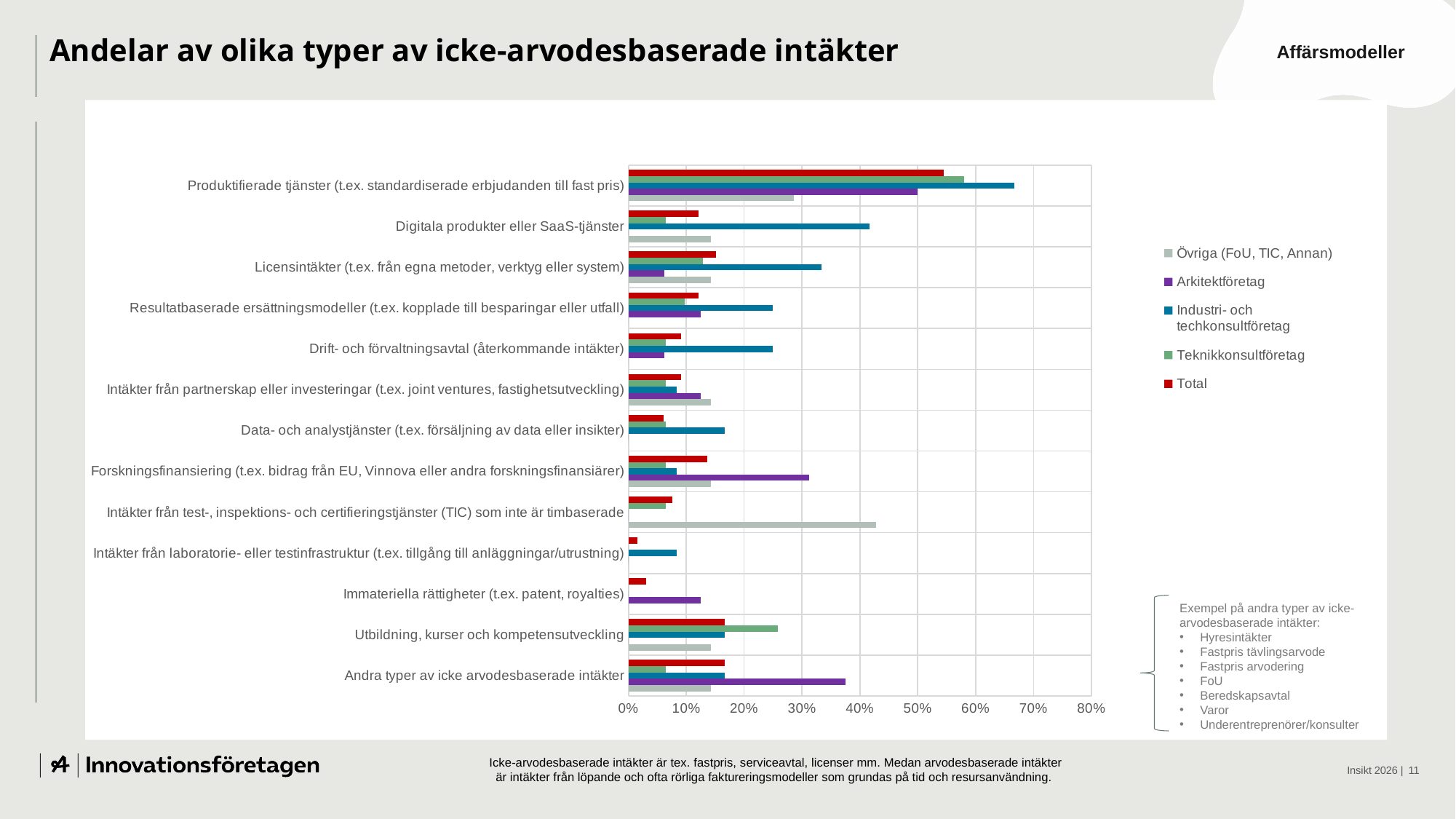
Which category has the highest Total value? Produktifierade tjänster (t.ex. standardiserade erbjudanden till fast pris) Is the value for Industri- och techkonsultföretag in the category 'Produktifierade tjänster' greater or less than 60%? greater How many series does the chart legend list? 5 Is the Total value for 'Immateriella rättigheter (t.ex. patent, royalties)' greater or less than 10%? less Is the Total value for 'Produktifierade tjänster' greater or less than 50%? greater For 'Digitala produkter eller SaaS-tjänster', which is larger: the value for Industri- och techkonsultföretag or the value for Övriga (FoU, TIC, Annan)? Industri- och techkonsultföretag For 'Forskningsfinansiering', which is larger: the value for Arkitektföretag or the Total value? Arkitektföretag What colour represents the Total series in the legend? Red How many categories of non-fee-based income are listed on the chart's vertical axis? 13 What kind of chart is shown on the slide? Bar chart